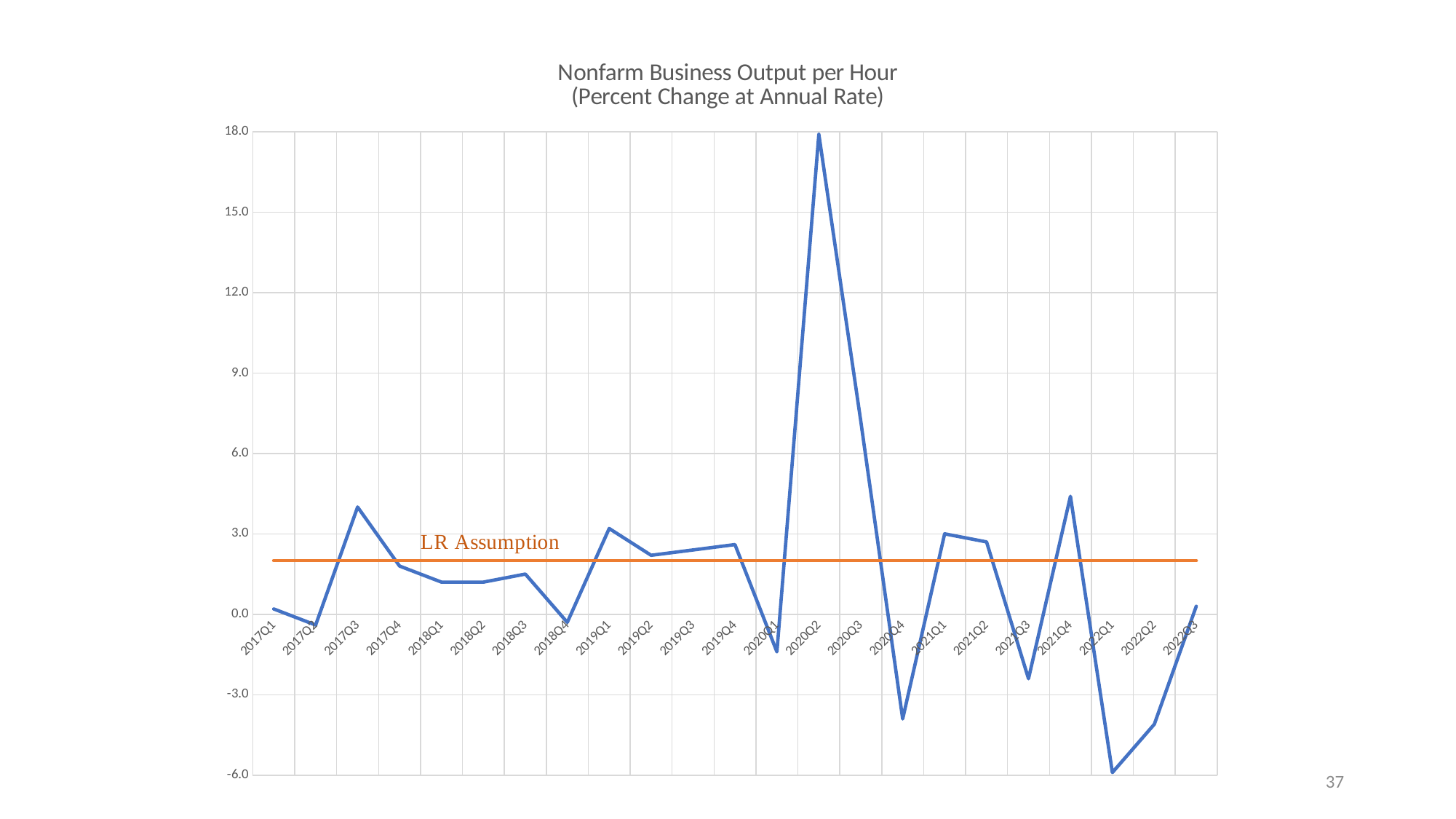
How many quarters are plotted along the x axis? 23 Which quarter has the highest value? 2020Q2 What is the title of the chart? Nonfarm Business Output per Hour (Percent Change at Annual Rate) Which is larger, the value for 2017Q3 or the value for 2018Q1? 2017Q3 Is the value for 2020Q2 greater or less than 15.0? greater Is the value for 2017Q3 greater or less than 3.0? greater Which is larger, the value for 2020Q2 or the value for 2021Q4? 2020Q2 Is the value for 2020Q4 greater or less than -3.0? less What kind of chart is shown on the slide? Line chart What is the label on the horizontal orange line in the chart? LR Assumption Which quarter has the lowest value? 2022Q1